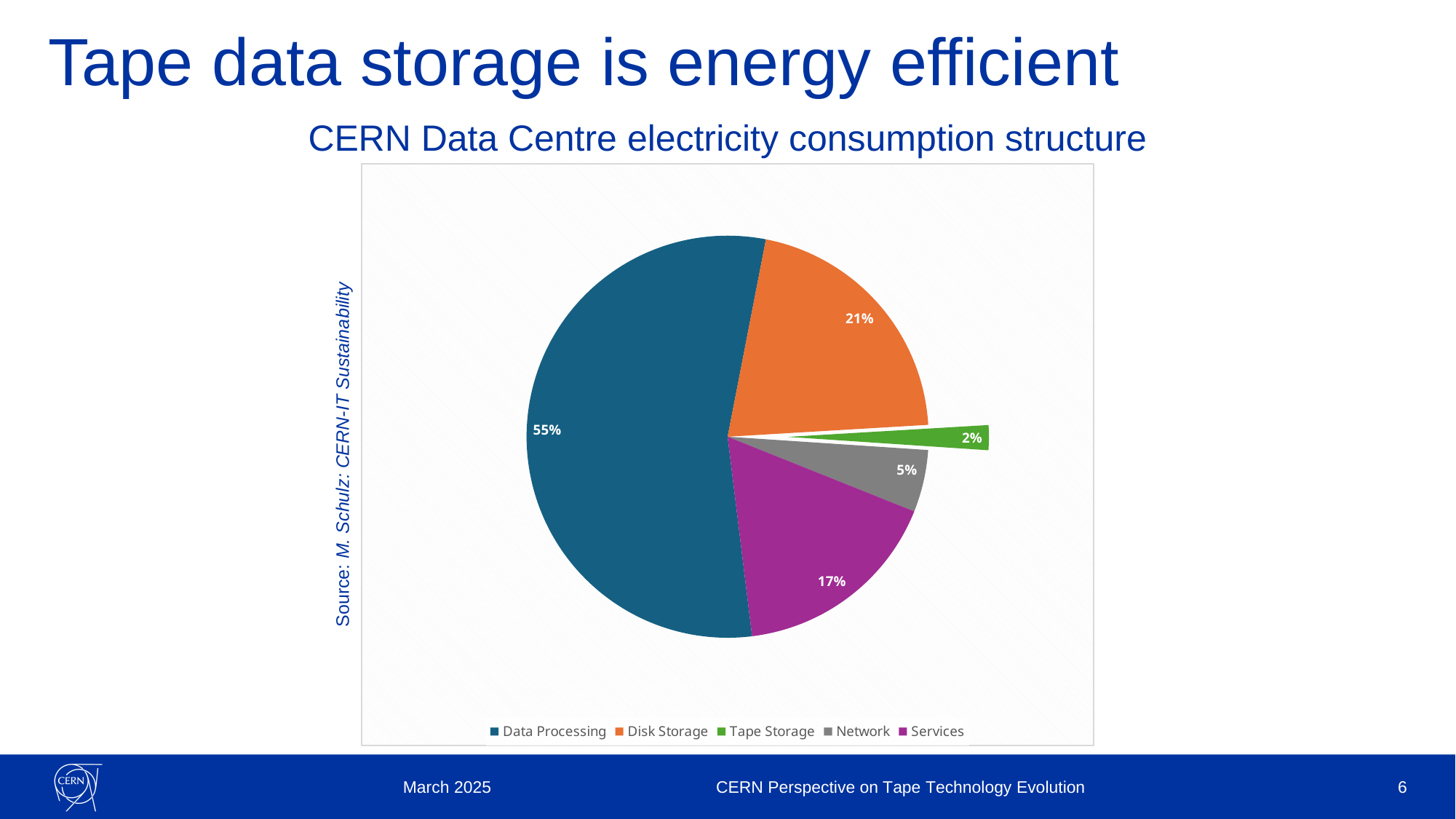
What share of electricity consumption does Services account for? 17% What share of electricity consumption does Disk Storage account for? 21% What share of electricity consumption does Data Processing account for? 55% How many categories are shown in the pie chart? 5 Which has a larger share of electricity consumption, Services or Network? Services What is the difference in percentage points between the Disk Storage and Tape Storage shares? 19 Which category has the largest share of electricity consumption? Data Processing What share of electricity consumption does Network account for? 5% What is the title of the chart? CERN Data Centre electricity consumption structure Which category has the smallest share of electricity consumption? Tape Storage What type of chart is shown on the slide? Pie chart What share of electricity consumption does Tape Storage account for? 2%